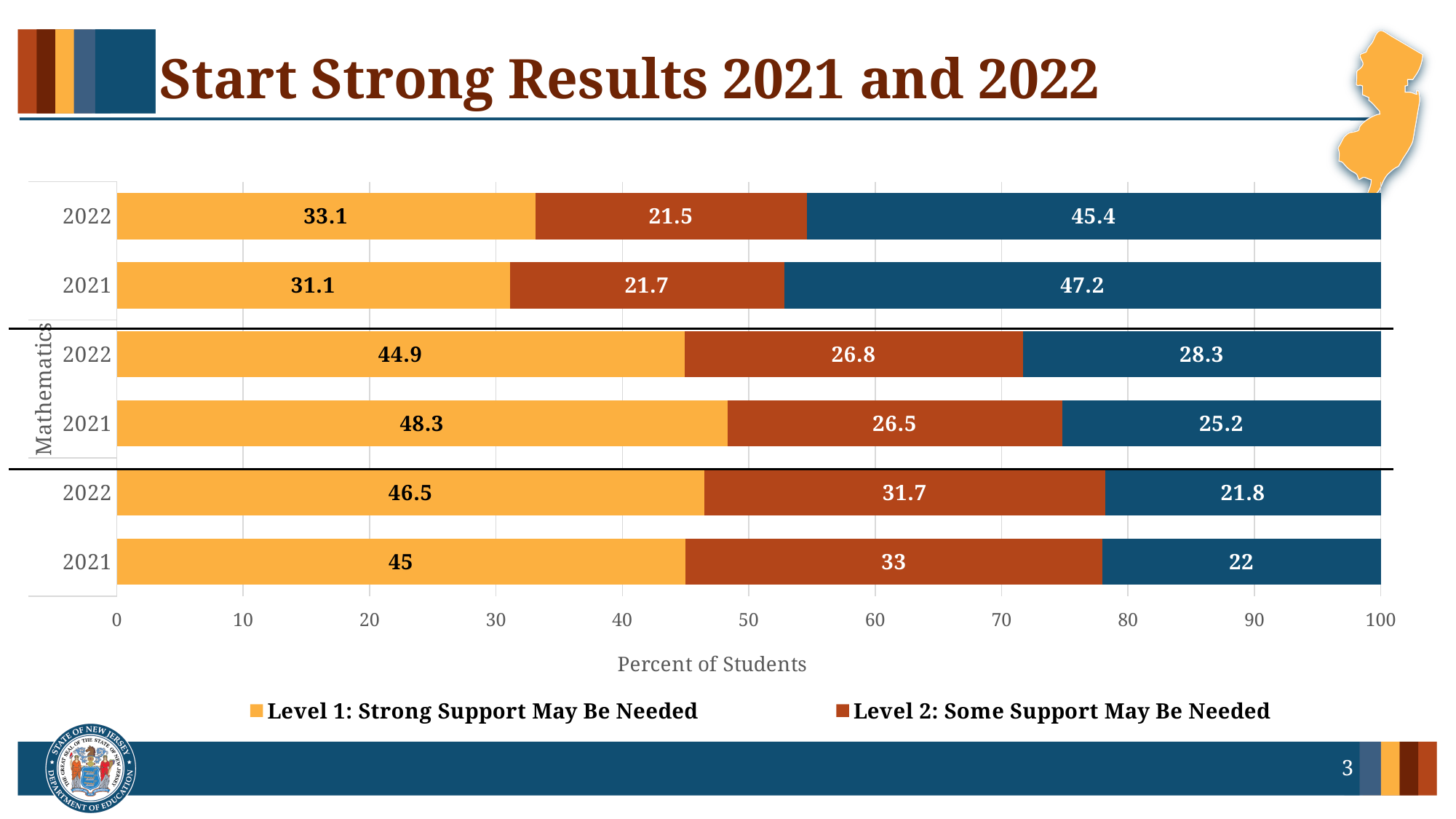
What kind of chart is shown on the slide? bar chart By how much did the Mathematics Level 1 value change from 2021 to 2022? 3.4 Which bar has the highest Level 1 value? Mathematics 2021 What is the Level 1 value for Mathematics in 2022? 44.9 For Mathematics in 2022, which is larger: the Level 1 value or the Level 2 value? Level 1 What is the Level 2 value in the bottom 2021 bar? 33 What is the lowest Level 2 value shown on the chart? 21.5 What is the Level 2 value for Mathematics in 2021? 26.5 What is the Level 1 value in the topmost 2022 bar? 33.1 How many series does the legend list? 2 How many bars are plotted on the chart? 6 What is the title of the horizontal axis? Percent of Students